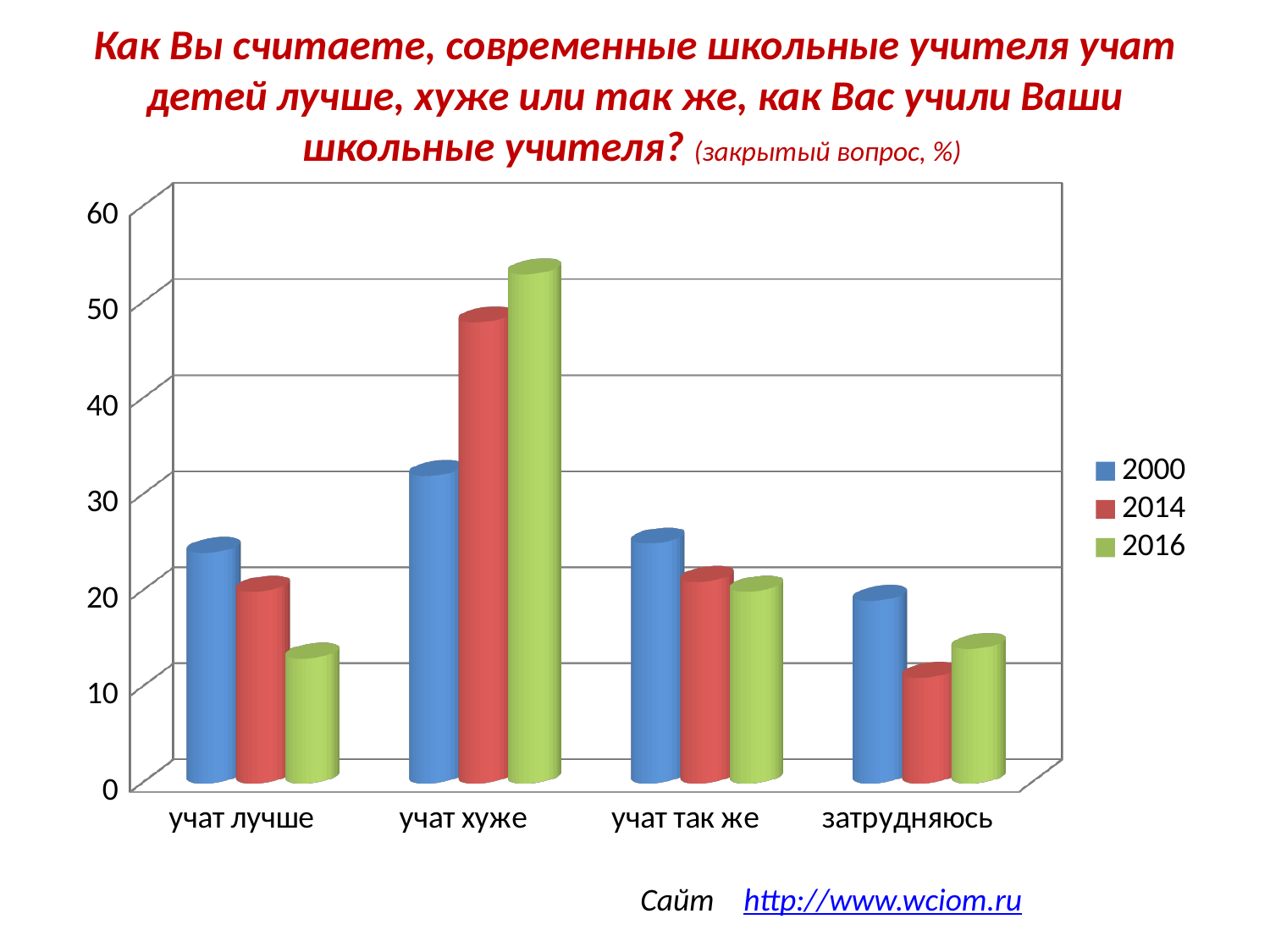
Which category has the tallest bar in the chart? учат хуже Is the value for 2014 in the category 'учат хуже' greater or less than 40? greater Do the values for 'учат хуже' rise or fall from 2000 to 2016? rise Is the value for 2016 in the category 'учат хуже' greater or less than 50? greater What kind of chart is shown on the slide? bar chart Which is larger for 'учат хуже': the value for 2000 or the value for 2016? 2016 For the category 'учат хуже', which year has the lowest value? 2000 Which years are listed in the legend? 2000, 2014, 2016 How many categories are shown on the x axis? 4 How many series does the legend list? 3 Is the value for 2016 in the category 'учат лучше' greater or less than 20? less For the category 'учат лучше', which year has the highest value? 2000